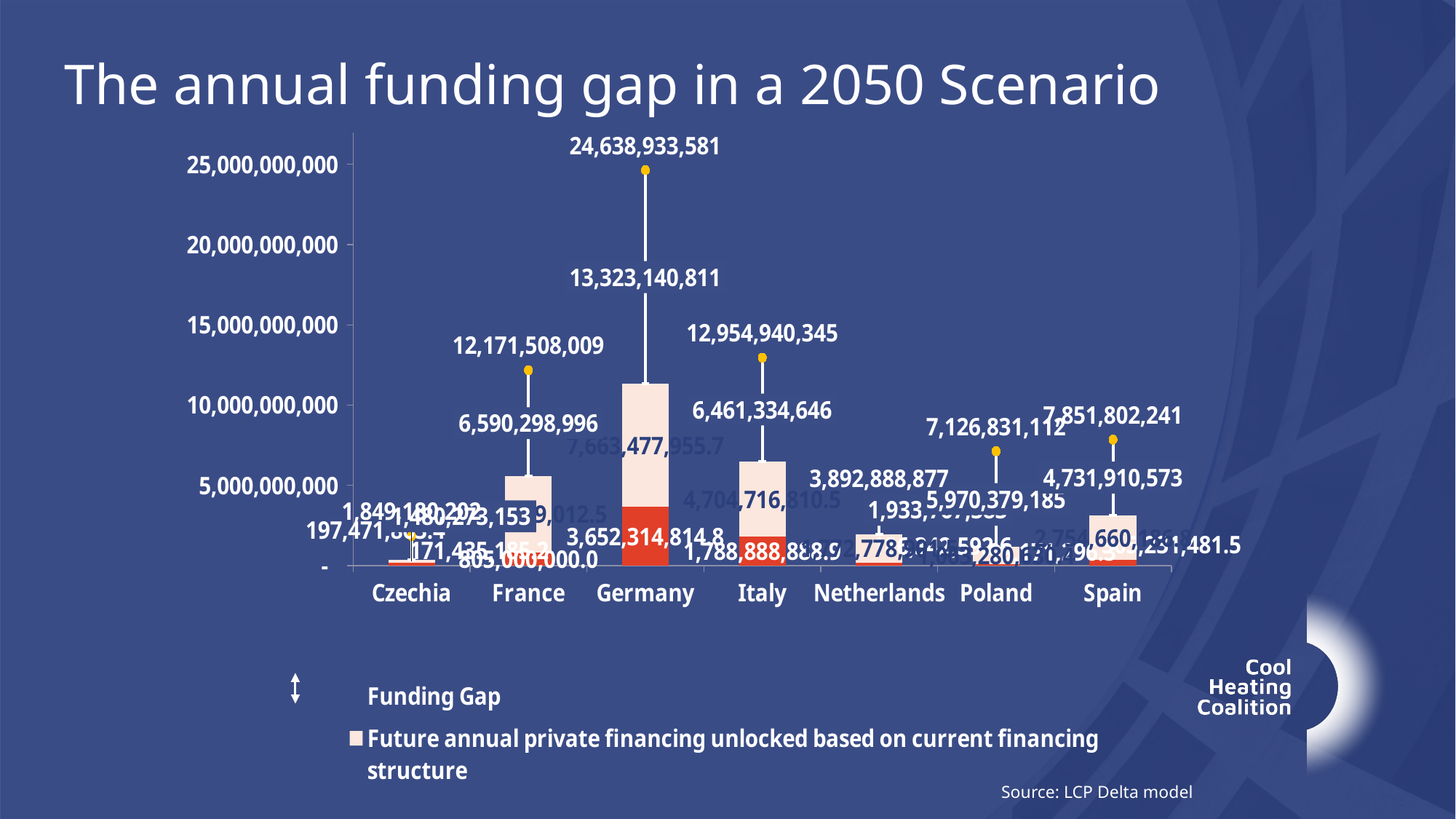
What is the topmost data label shown for Germany? 24,638,933,581 What is the topmost data label shown for Spain? 7,851,802,241 What is the topmost data label shown for Poland? 7,126,831,112 What kind of chart is shown on the slide? bar chart How many countries are shown on the x axis of the chart? 7 Which country has the lowest topmost data label in the chart? Czechia Which country has the highest topmost data label in the chart? Germany What source is cited for the chart? LCP Delta model What is the topmost data label shown for France? 12,171,508,009 What is the topmost data label shown for Italy? 12,954,940,345 What is the difference between the topmost data labels of Germany and France? 12,467,425,572 How many entries does the chart legend list? 2